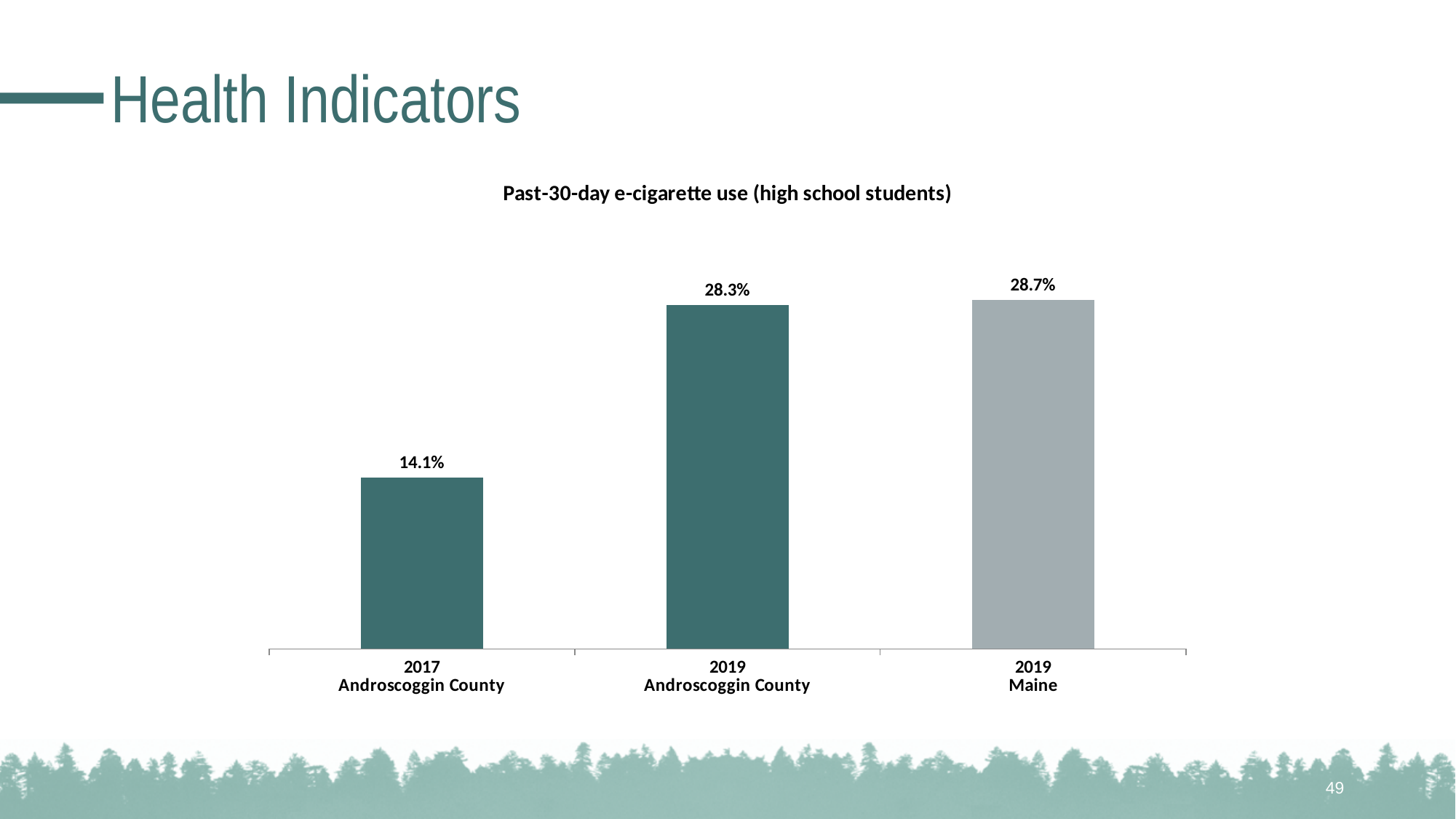
What is the title of the chart? Past-30-day e-cigarette use (high school students) How many bars are shown in the chart? 3 Which is larger: the value for 2017 Androscoggin County or the value for 2019 Androscoggin County? 2019 Androscoggin County What is the difference between the 2019 Maine value and the 2019 Androscoggin County value? 0.4% Which bar is shown in a lighter grey colour than the others? 2019 Maine What is the past-30-day e-cigarette use value for 2017 Androscoggin County? 14.1% What is the past-30-day e-cigarette use value for 2019 Maine? 28.7% Do the values rise or fall from left to right across the chart? Rise What is the past-30-day e-cigarette use value for 2019 Androscoggin County? 28.3% What is the difference between the 2019 Androscoggin County value and the 2017 Androscoggin County value? 14.2% What kind of chart is shown on the slide? Bar chart Which category has the lowest value in the chart? 2017 Androscoggin County